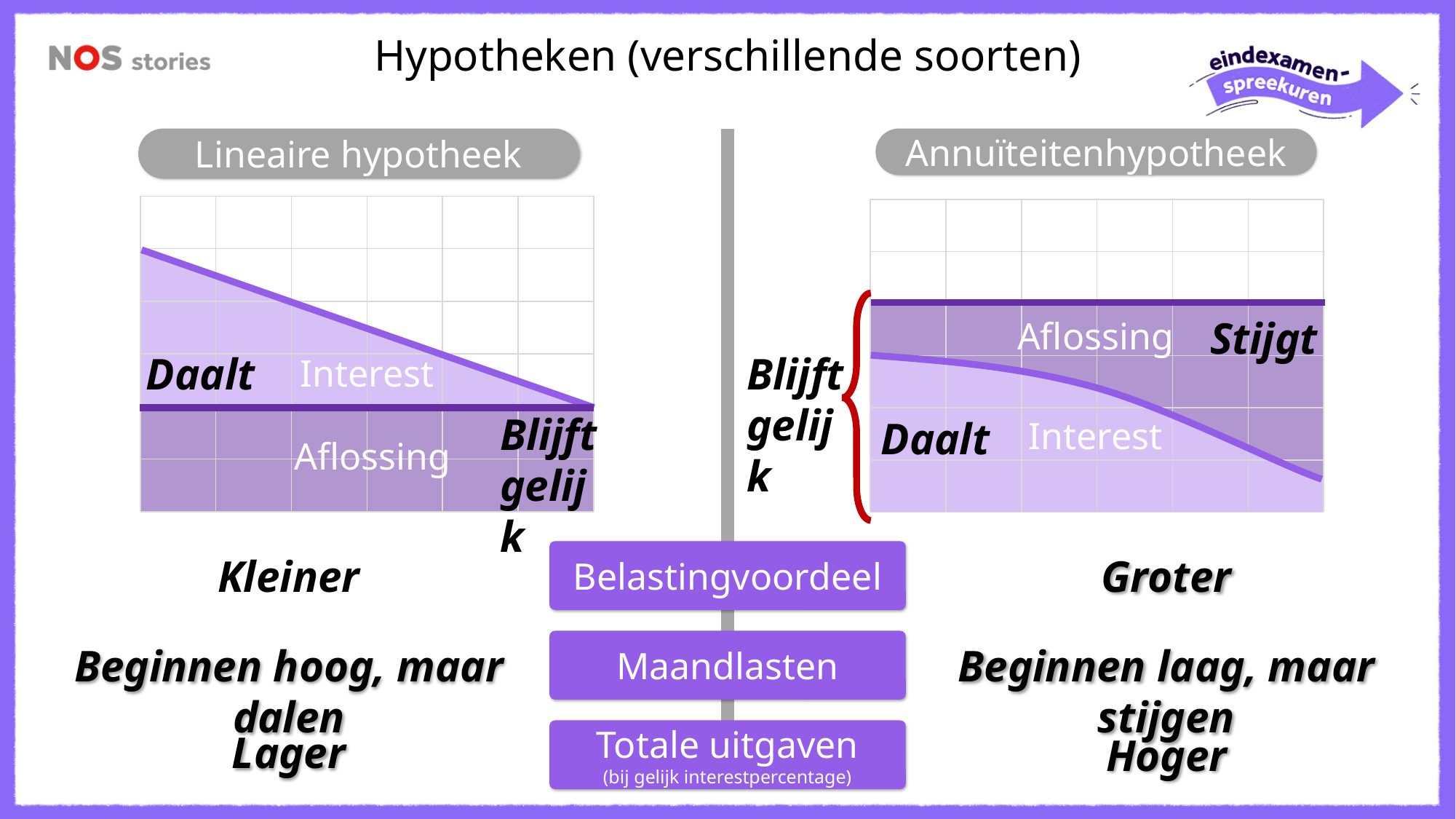
How many series are plotted in the "Lineaire hypotheek" chart? 2 What is the title of the chart on the left of the slide? Lineaire hypotheek In the "Lineaire hypotheek" chart, which component is larger at the left edge of the chart: Interest or Aflossing? Interest In the "Annuïteitenhypotheek" chart, does the Interest area rise or fall along the x axis? fall In the "Annuïteitenhypotheek" chart, does the Aflossing area rise or fall along the x axis? rise How many series are plotted in the "Annuïteitenhypotheek" chart? 2 In the "Lineaire hypotheek" chart, does the Interest area rise or fall along the x axis? fall In the "Annuïteitenhypotheek" chart, which component is larger at the right edge of the chart: Aflossing or Interest? Aflossing Which two components are labelled in the "Annuïteitenhypotheek" chart? Aflossing and Interest What type of chart is the "Lineaire hypotheek" chart? area chart